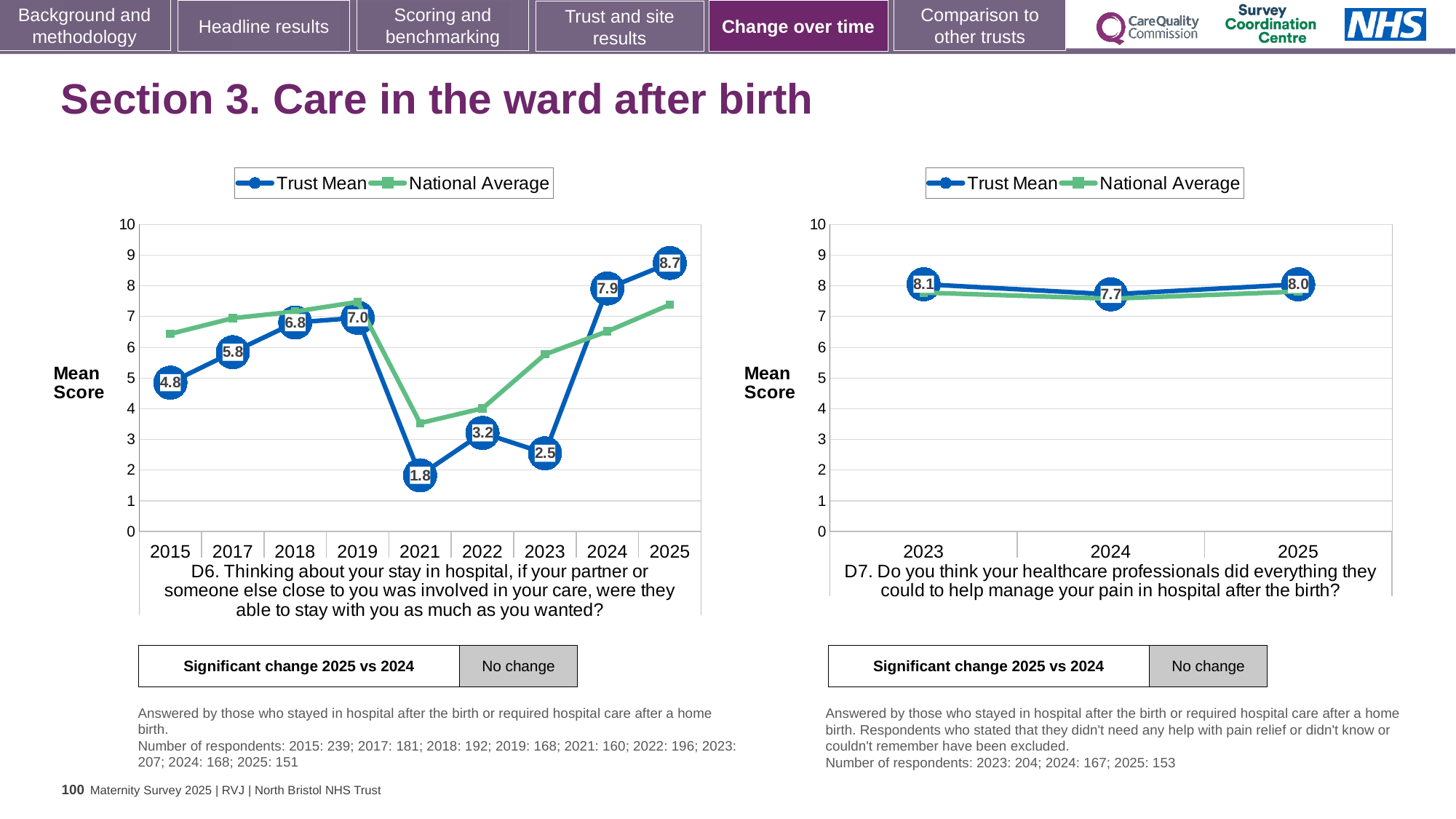
In the D6 chart on the left, what is the difference between the Trust Mean scores for 2025 and 2024? 0.8 In the D6 chart on the left, which year has the highest Trust Mean score? 2025 In the D6 chart on the left, what is the Trust Mean score for 2021? 1.8 In the D7 chart on the right, what is the difference between the Trust Mean scores for 2023 and 2024? 0.4 In the D6 chart on the left, what is the Trust Mean score for 2025? 8.7 In the D6 chart on the left, which year has the lowest Trust Mean score? 2021 How many series does the legend of the D7 chart on the right list? 2 In the D6 chart on the left, is the Trust Mean score for 2022 greater or less than the score for 2023? greater How many years are plotted on the x axis of the D6 chart on the left? 9 What kind of chart is the D7 chart on the right? Line chart In the D7 chart on the right, what is the Trust Mean score for 2024? 7.7 In the D6 chart on the left, is the National Average value for 2021 greater or less than 4? less